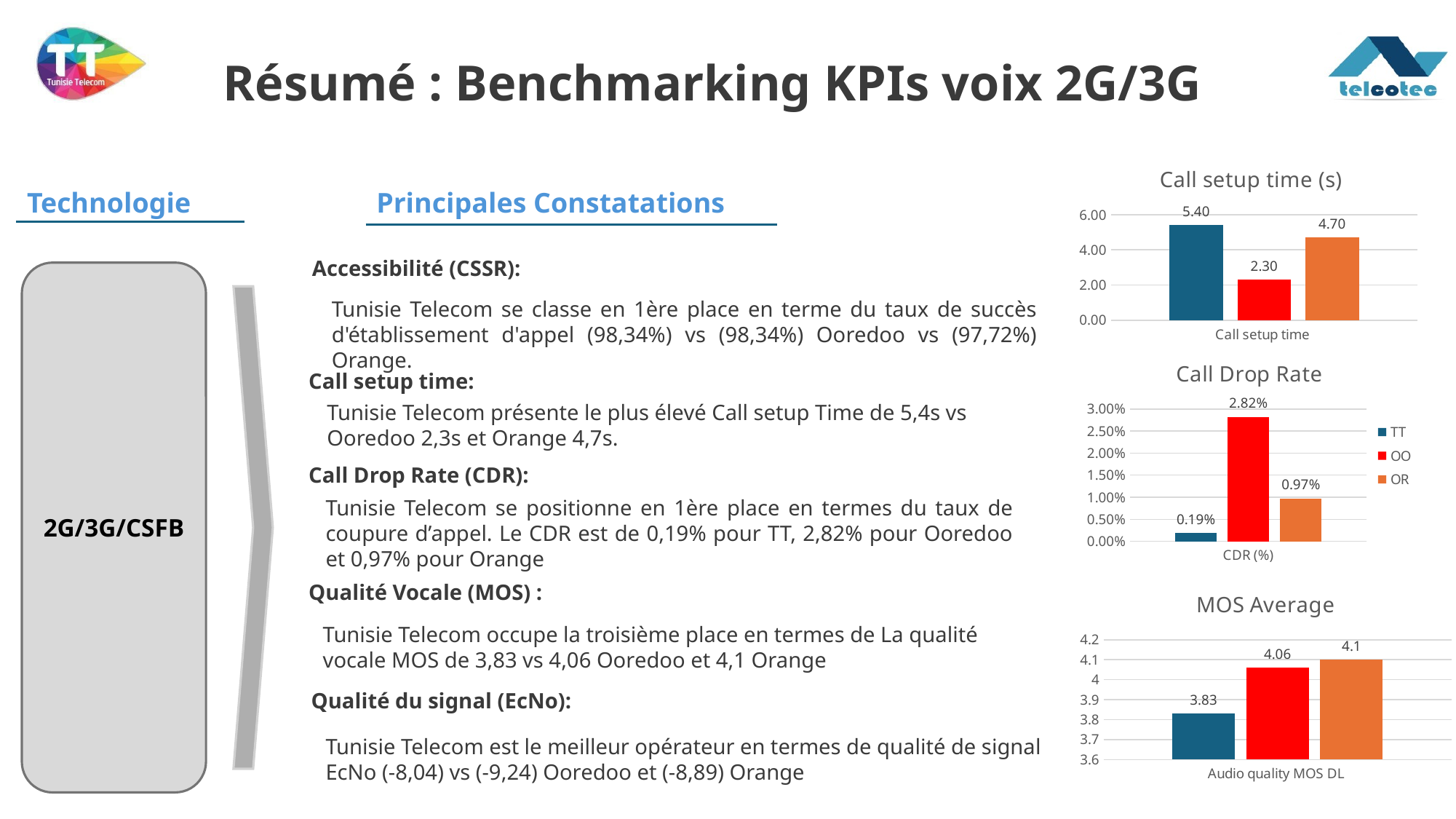
In the MOS Average chart, what is the value of the blue bar? 3.83 In the MOS Average chart, which bar is higher, the red bar or the orange bar? the orange bar In the Call Drop Rate chart, what is the value for OO? 2.82% In the Call Drop Rate chart, what is the difference between the OO and OR values? 1.85% In the Call setup time (s) chart, what is the difference between the blue bar and the orange bar? 0.70 In the MOS Average chart, is the value of the blue bar greater or less than 4? less In the Call Drop Rate chart, what is the value for TT? 0.19% In the Call setup time (s) chart, what is the value of the red bar? 2.30 In the Call Drop Rate chart, which series has the lowest value? TT How many series does the legend of the Call Drop Rate chart list? 3 What type of chart is the MOS Average chart? bar chart In the Call setup time (s) chart, what is the value of the tallest bar? 5.40